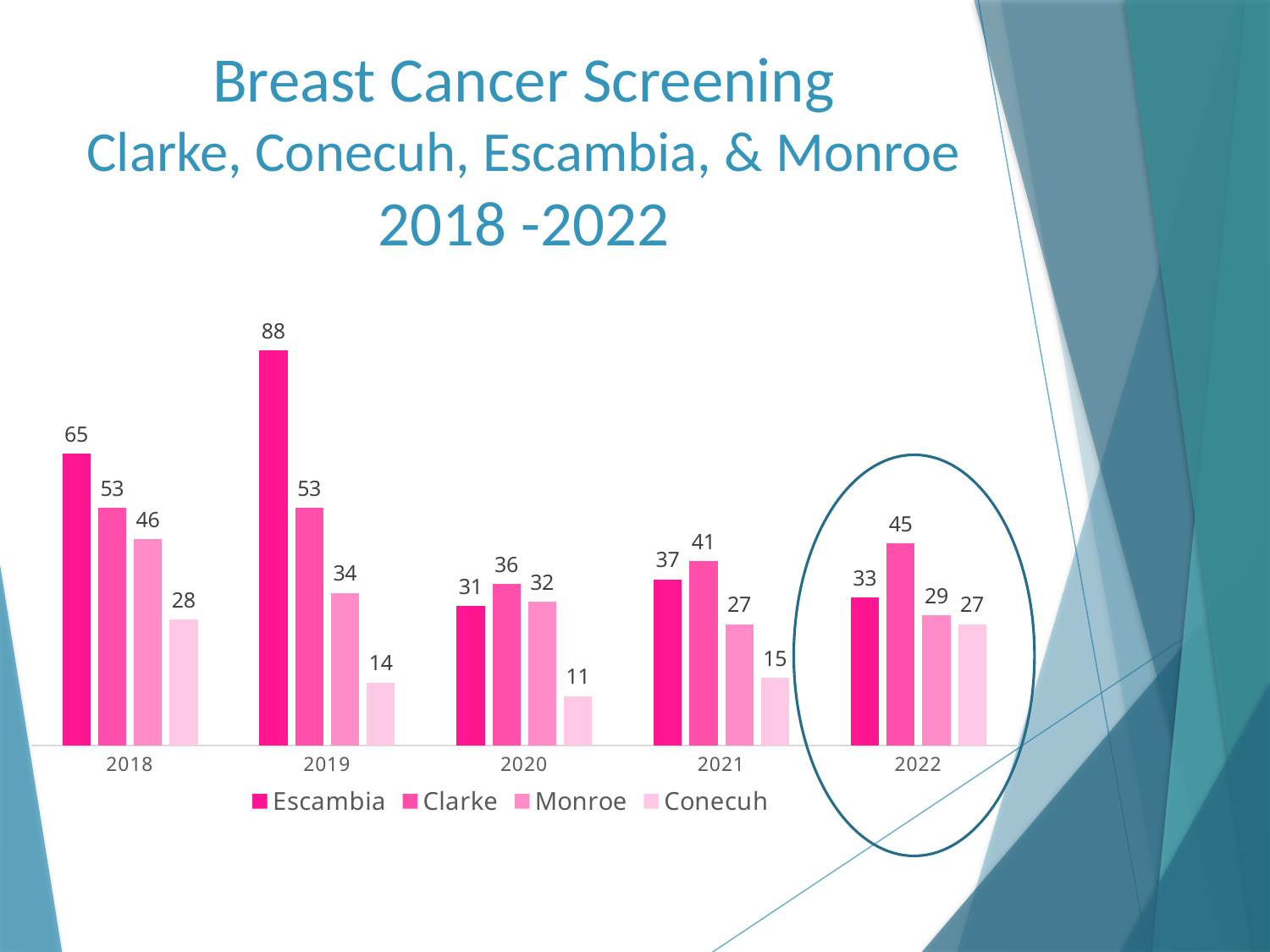
What is the difference between the Escambia and Conecuh values in 2019? 74 Does the Monroe value rise or fall from 2018 to 2020? Fall In which year is the Escambia value highest? 2019 In which year is the Conecuh value lowest? 2020 What is the value for Escambia in 2019? 88 Which is larger in 2021, the Escambia value or the Clarke value? Clarke What kind of chart is shown on the slide? Bar chart What is the value for Monroe in 2021? 27 How many series does the legend list? 4 What is the value for Conecuh in 2020? 11 How many years are shown on the x axis? 5 What is the value for Clarke in 2022? 45